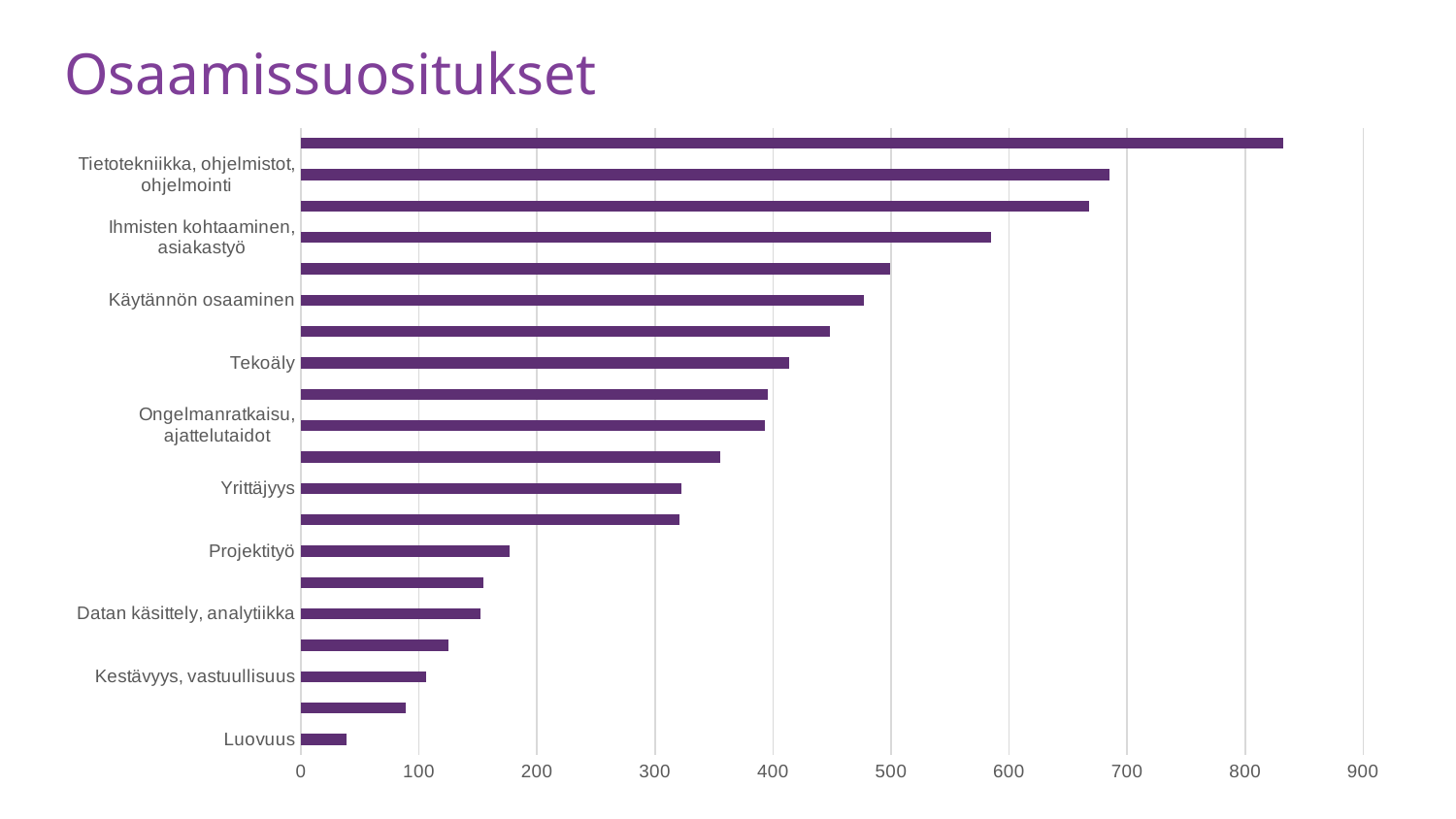
What is the title of the slide? Osaamissuositukset Is the value for Projektityö greater or less than 200? less Is the value for Käytännön osaaminen greater or less than 500? less Which has the larger value, Tekoäly or Yrittäjyys? Tekoäly Is the value for Luovuus greater or less than 100? less What type of chart is shown on the slide? bar chart Do the bar values increase or decrease going from the top of the chart to the bottom? decrease How many bars are plotted in the chart? 20 Which of the labelled categories has the lowest value? Luovuus